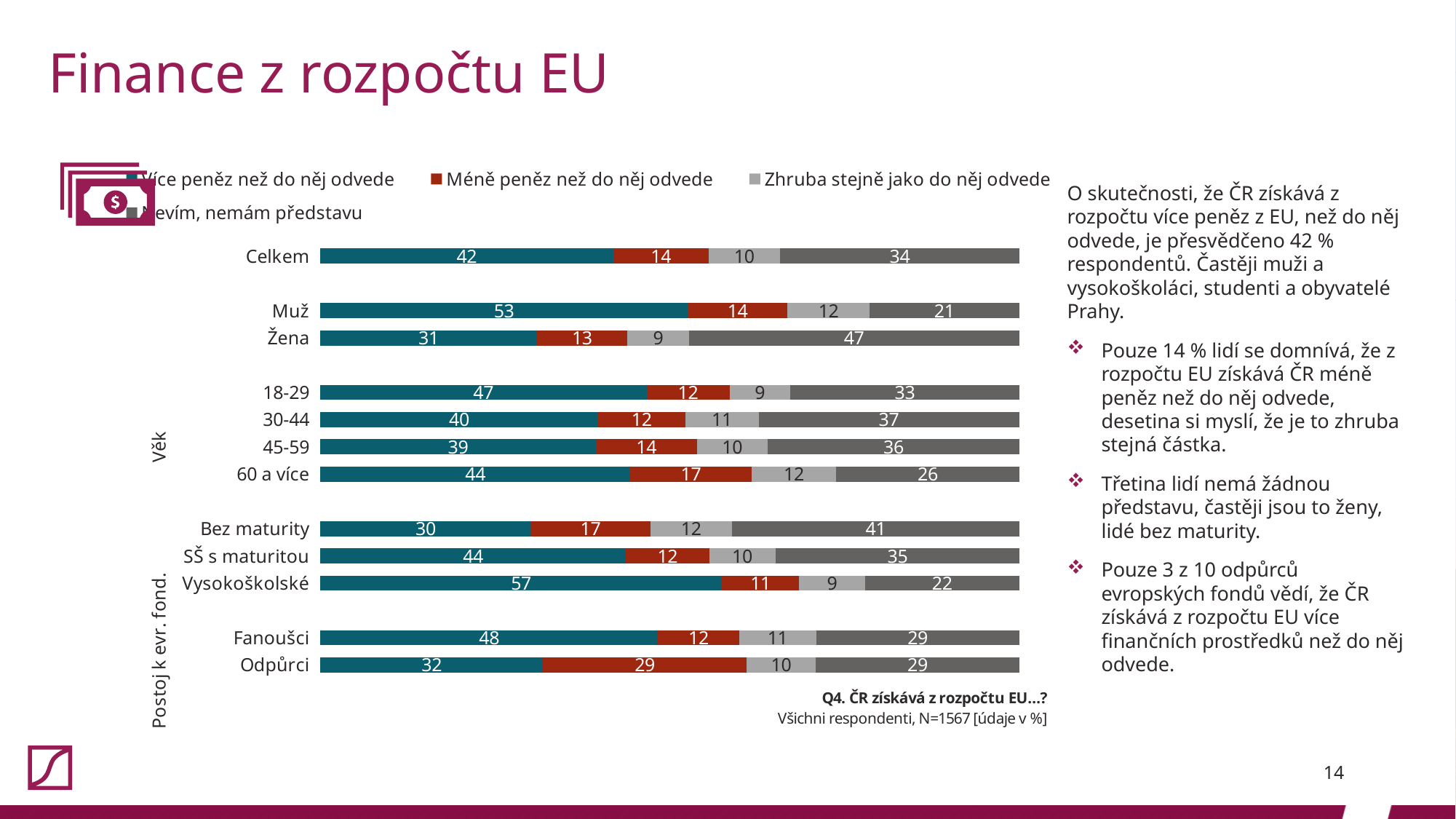
What is the value of 'Méně peněz než do něj odvede' for Odpůrci? 29 What is the value of 'Více peněz než do něj odvede' for Celkem? 42 Which category has the lowest value for 'Více peněz než do něj odvede'? Bez maturity What type of chart is shown on the slide? stacked bar chart How many series does the legend list? 4 What is the difference between the 'Více peněz než do něj odvede' values for Muž and Žena? 22 Which category has the highest value for 'Více peněz než do něj odvede'? Vysokoškolské What is the total of the stacked bar for Fanoušci? 100 Which has a larger 'Nevím, nemám představu' value, 18-29 or 60 a více? 18-29 How many categories (rows) are plotted in the chart? 12 What is the value of 'Zhruba stejně jako do něj odvede' for 30-44? 11 What is the value of 'Nevím, nemám představu' for Žena? 47